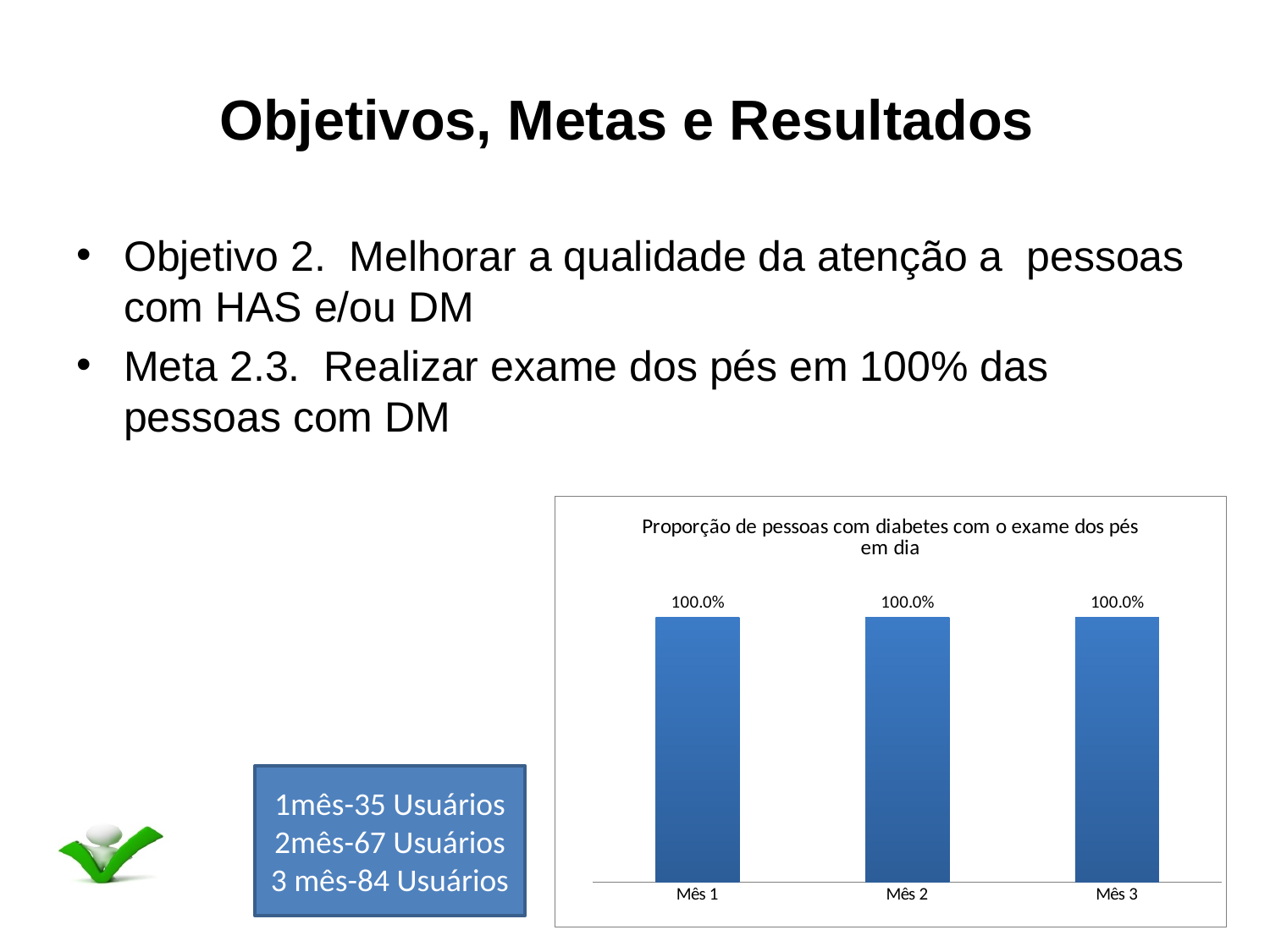
What kind of chart is shown on the slide? bar chart What is the value for Mês 2 in the chart? 100.0% Is the value for Mês 2 greater or less than 50%? greater Do the values rise, fall, or stay the same from Mês 1 to Mês 3? stay the same What is the value for Mês 1 in the chart? 100.0% What is the title of the chart? Proporção de pessoas com diabetes com o exame dos pés em dia What is the difference between the values for Mês 3 and Mês 1? 0.0% What is the value for Mês 3 in the chart? 100.0% How many categories (months) are plotted in the chart? 3 What colour are the bars in the chart? blue